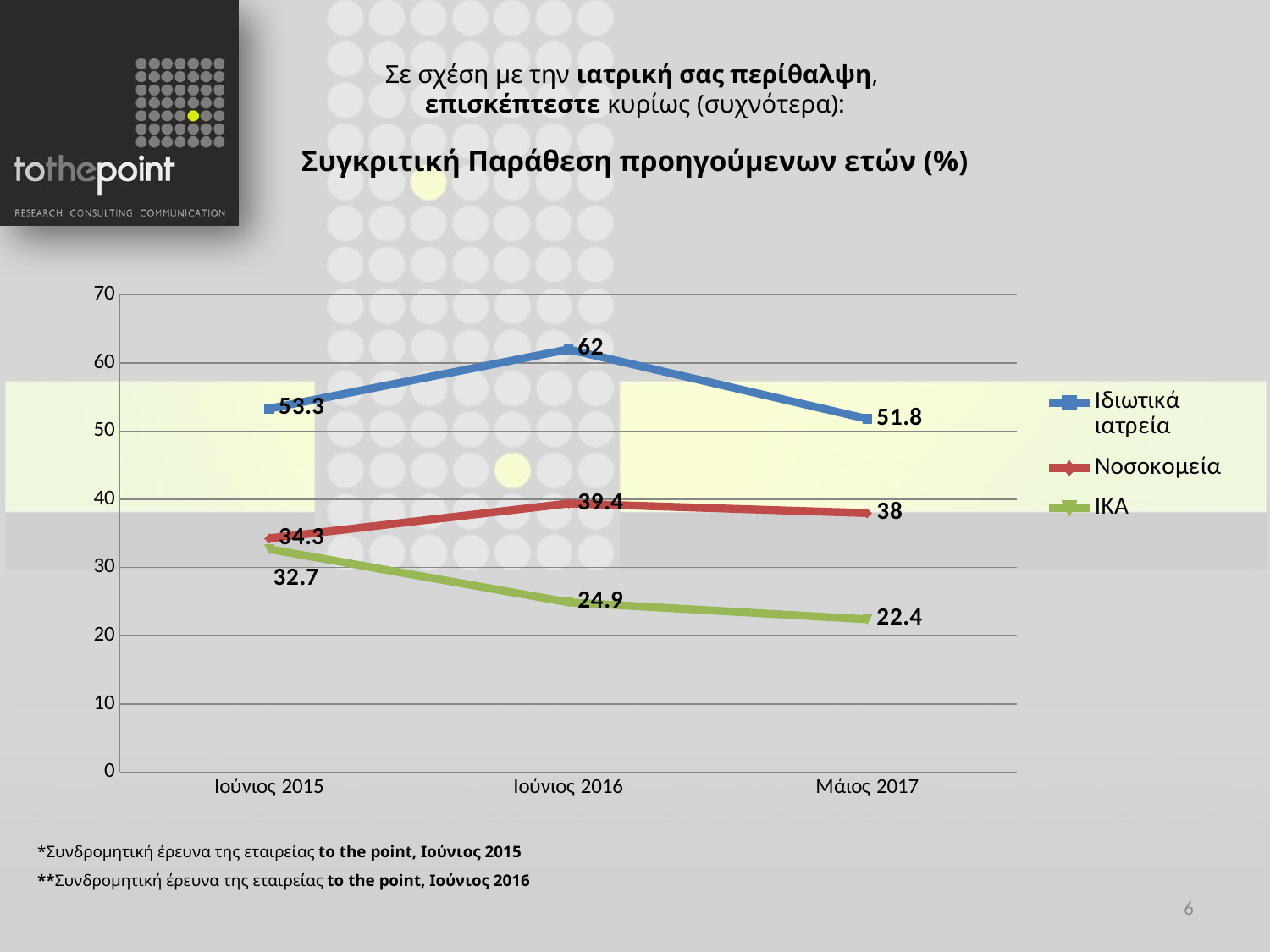
In which period is the value for Ιδιωτικά ιατρεία highest? Ιούνιος 2016 How many time points are shown on the x axis? 3 Does the ΙΚΑ series rise or fall from Ιούνιος 2015 to Μάιος 2017? Fall What is the value for Ιδιωτικά ιατρεία in Ιούνιος 2016? 62 How many series does the legend list? 3 What is the difference between the Ιδιωτικά ιατρεία values in Ιούνιος 2016 and Μάιος 2017? 10.2 What is the value for Νοσοκομεία in Ιούνιος 2015? 34.3 What is the value for ΙΚΑ in Μάιος 2017? 22.4 Which is larger in Ιούνιος 2015: Νοσοκομεία or ΙΚΑ? Νοσοκομεία Which series is shown in green in the legend? ΙΚΑ In which period is the value for ΙΚΑ lowest? Μάιος 2017 What type of chart is shown on the slide? Line chart